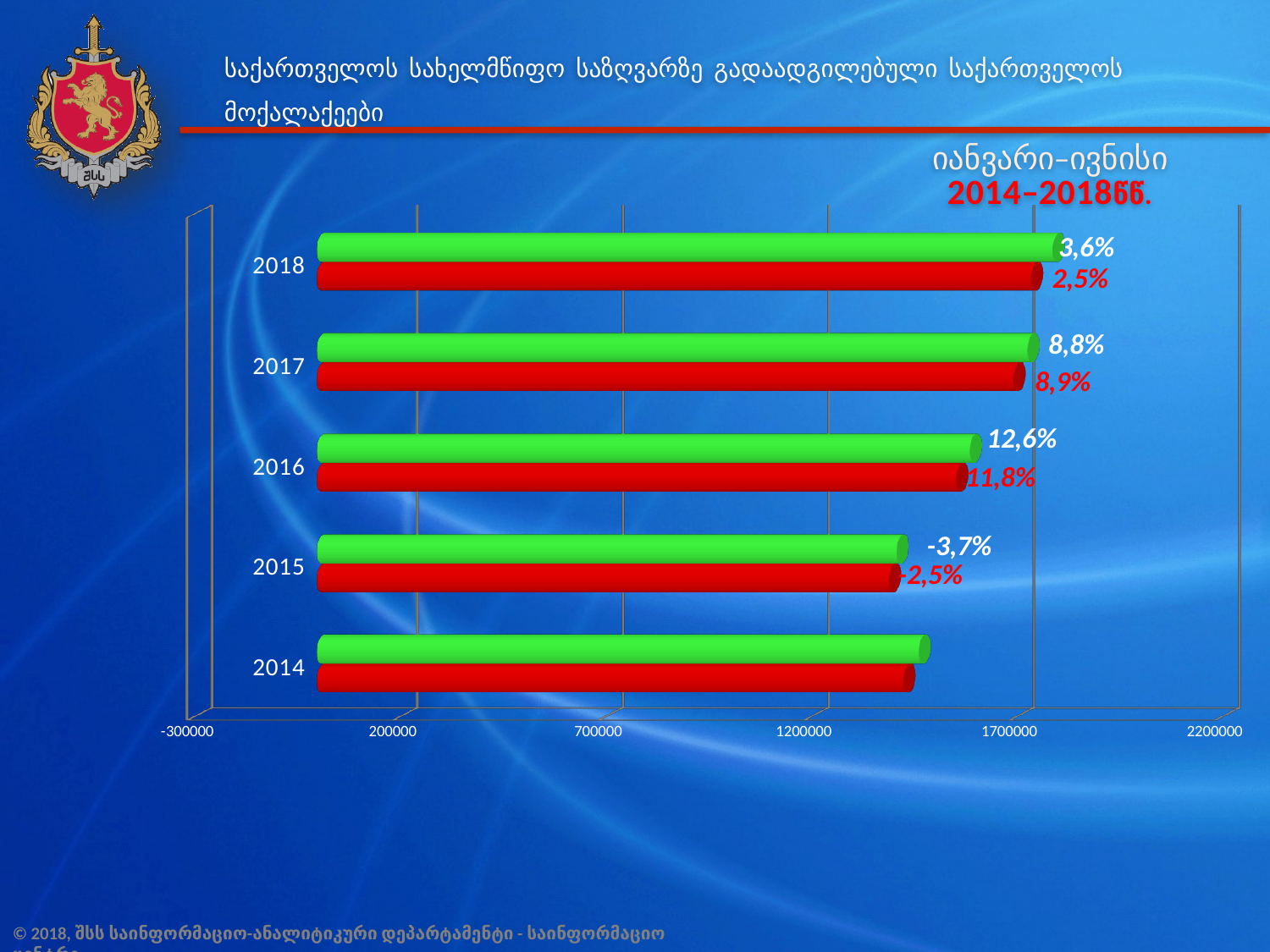
Is the green bar for 2016 greater or less than 1200000? greater What percentage label is printed next to the red bar for 2018? 2,5% What percentage label is printed next to the green bar for 2017? 8,8% What percentage label is printed next to the red bar for 2015? -2,5% What percentage label is printed next to the green bar for 2016? 12,6% Which year has the longest green bar? 2018 How many bars are plotted for each year on the chart? 2 Is the green bar for 2014 greater or less than 1700000? less What percentage label is printed next to the green bar for 2018? 3,6% What kind of chart is shown on the slide? bar chart Which year has the shortest green bar? 2015 How many years (categories) are shown on the chart? 5